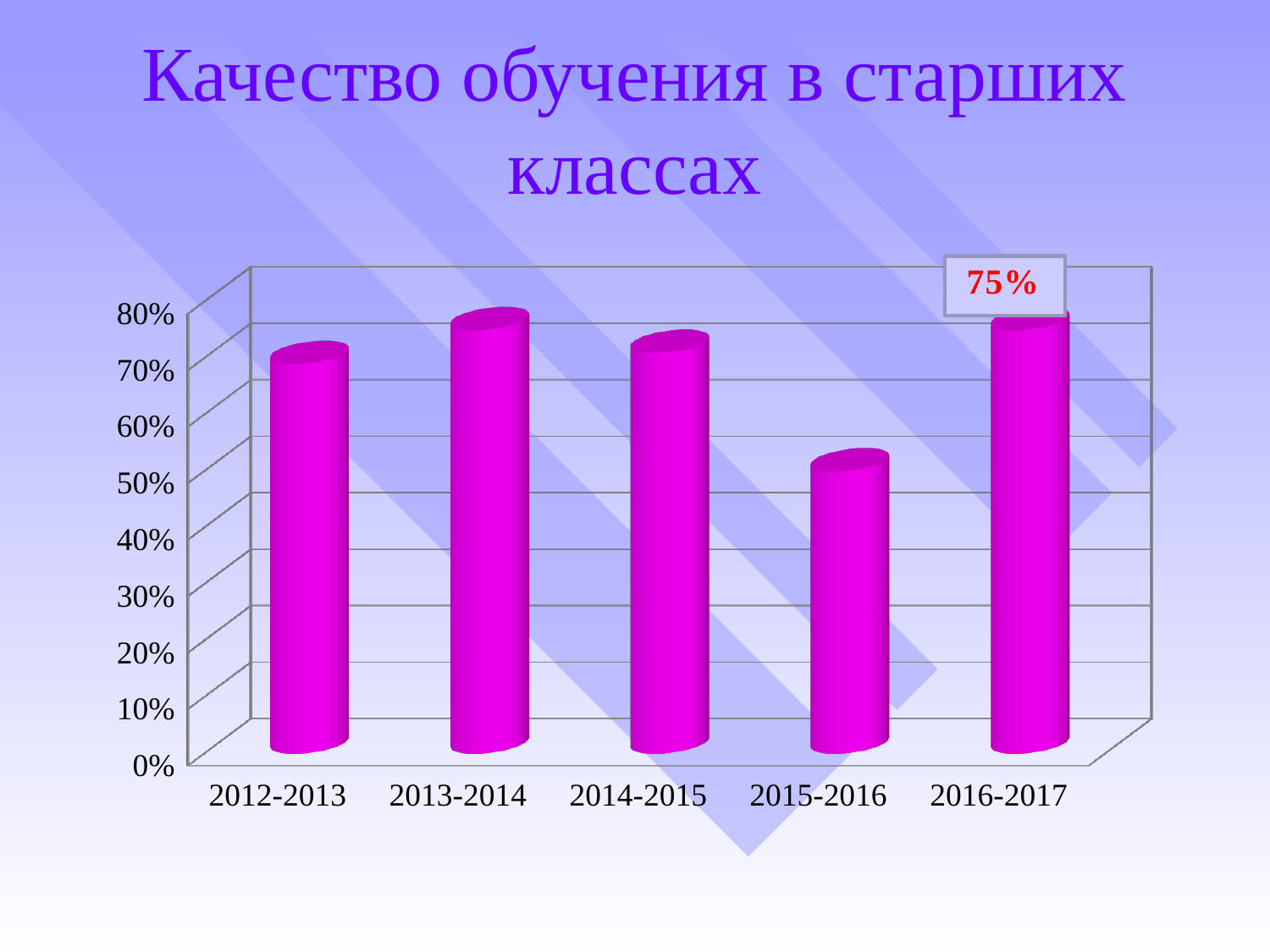
Does the value rise or fall from 2015-2016 to 2016-2017? rise Is the value for 2012-2013 greater or less than 60%? greater Is the value for 2015-2016 greater or less than 60%? less How many school years are shown on the chart? 5 What kind of chart is shown on the slide? bar chart Which is larger, the value for 2012-2013 or for 2015-2016? 2012-2013 Is the value for 2014-2015 greater or less than 60%? greater What is the value shown for 2016-2017? 75% Which school year has the lowest value? 2015-2016 Which is larger, the value for 2014-2015 or for 2015-2016? 2014-2015 What is the title of the slide? Качество обучения в старших классах